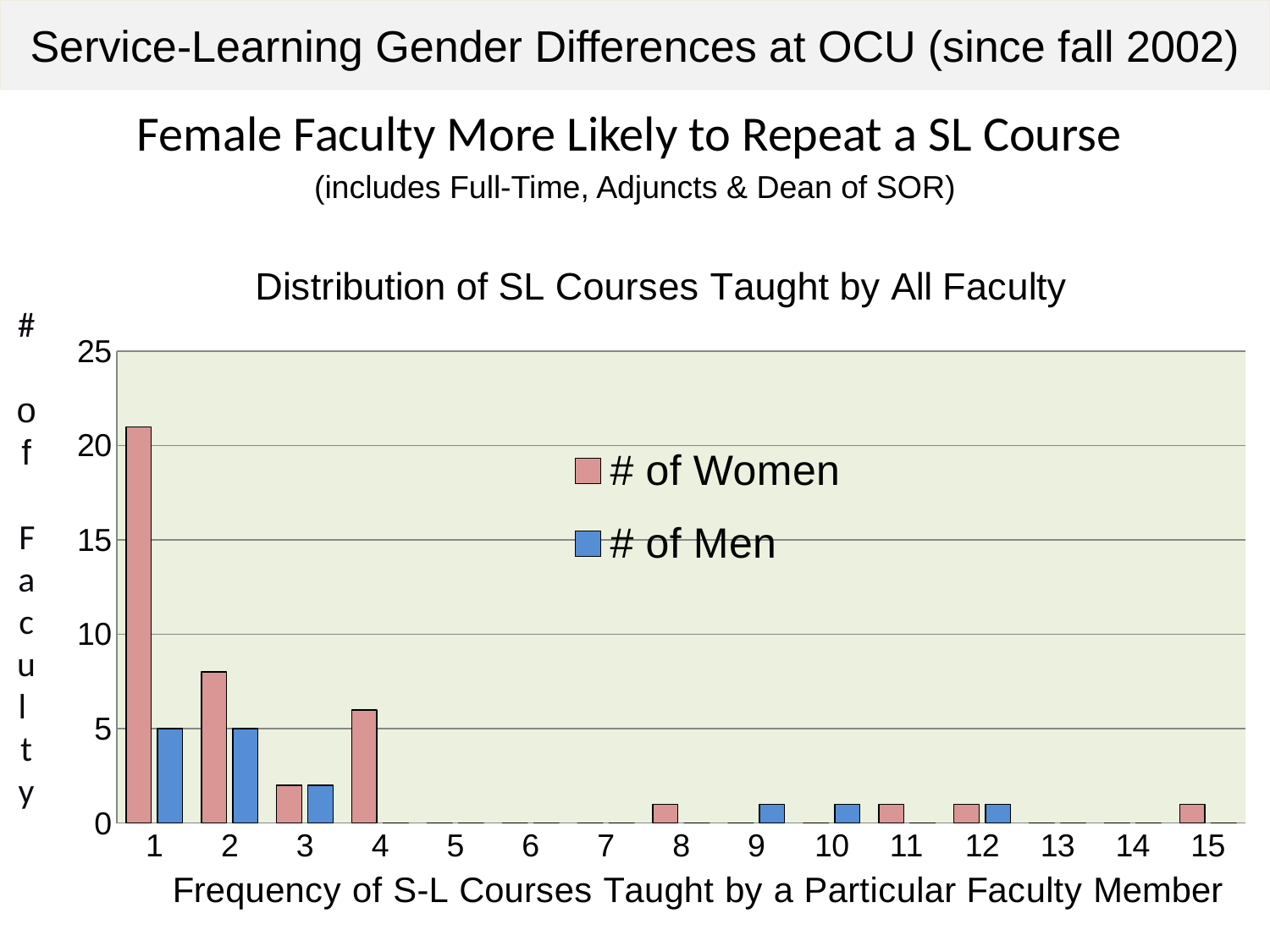
How many series does the legend list? 2 At which frequency is the # of Women bar highest? 1 Is the value for # of Women at frequency 1 greater or less than 20? greater Which is larger at frequency 1, # of Women or # of Men? # of Women What are the two series named in the legend? # of Women and # of Men How many categories are shown on the x axis? 15 What is the title of the chart? Distribution of SL Courses Taught by All Faculty What is the value for # of Men at frequency 2? 5 Is the value for # of Women at frequency 2 greater or less than 10? less What kind of chart is shown on the slide? bar chart What is the value for # of Men at frequency 1? 5 Is the value for # of Women at frequency 4 greater or less than 5? greater